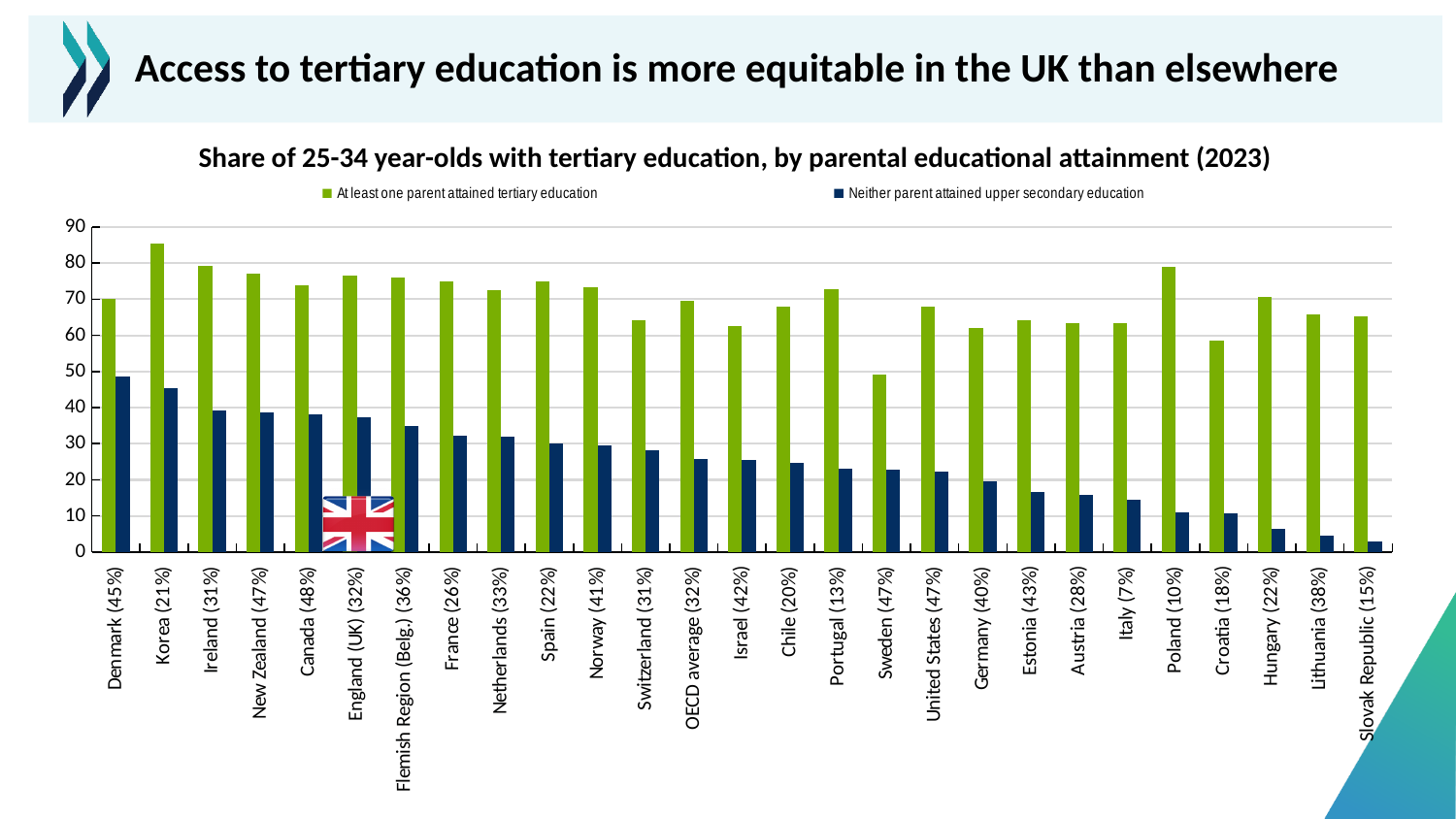
Which is larger for Denmark: the 'At least one parent attained tertiary education' bar or the 'Neither parent attained upper secondary education' bar? At least one parent attained tertiary education Is the value for Slovak Republic in the 'Neither parent attained upper secondary education' series greater or less than 10? less What kind of chart is shown on the slide? bar chart How many series does the legend list? 2 Which country has the lowest value for 'At least one parent attained tertiary education'? Sweden (47%) Is the value for Croatia in the 'At least one parent attained tertiary education' series greater or less than 60? less Do the values for 'Neither parent attained upper secondary education' rise or fall from left to right along the x axis? fall Which country has the lowest value for 'Neither parent attained upper secondary education'? Slovak Republic (15%) Which country has the highest value for 'Neither parent attained upper secondary education'? Denmark (45%) Which country has the highest value for 'At least one parent attained tertiary education'? Korea (21%) How many countries or regions are shown on the x axis? 27 Is the value for Korea in the 'At least one parent attained tertiary education' series greater or less than 80? greater